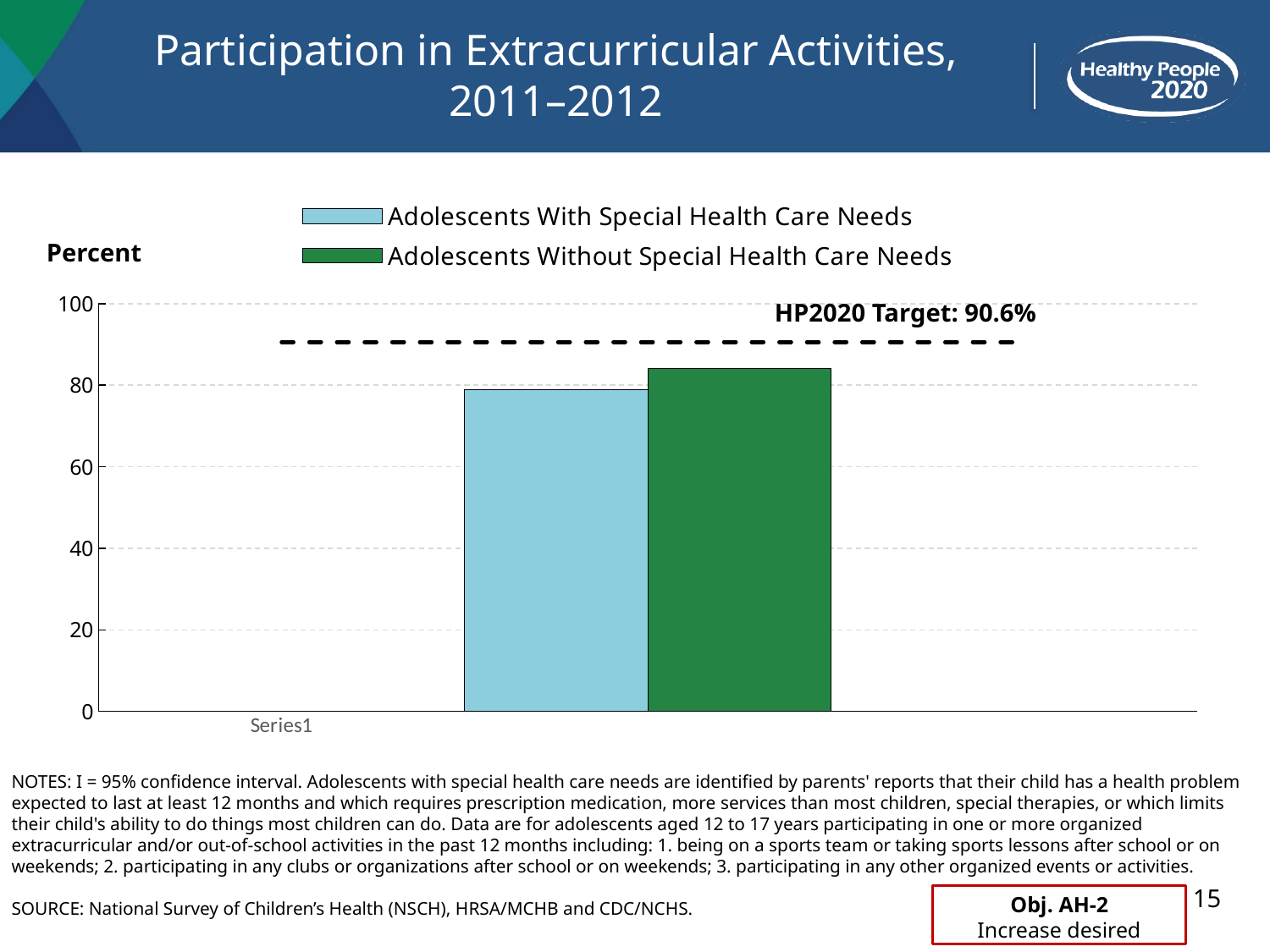
How many series does the legend list? 2 Is the value for Adolescents With Special Health Care Needs greater or less than 60? greater What kind of chart is shown on the slide? bar chart Is the value for Adolescents Without Special Health Care Needs greater or less than 100? less What is the title of the chart on the slide? Participation in Extracurricular Activities, 2011–2012 What is the HP2020 Target value shown on the chart? 90.6% How many bars are plotted in the chart? 2 Which group has the highest value in the chart? Adolescents Without Special Health Care Needs What is the label on the vertical axis of the chart? Percent Which group has the higher bar: Adolescents With Special Health Care Needs or Adolescents Without Special Health Care Needs? Adolescents Without Special Health Care Needs Is the value for Adolescents Without Special Health Care Needs greater or less than 60? greater Which group has the lowest value in the chart? Adolescents With Special Health Care Needs